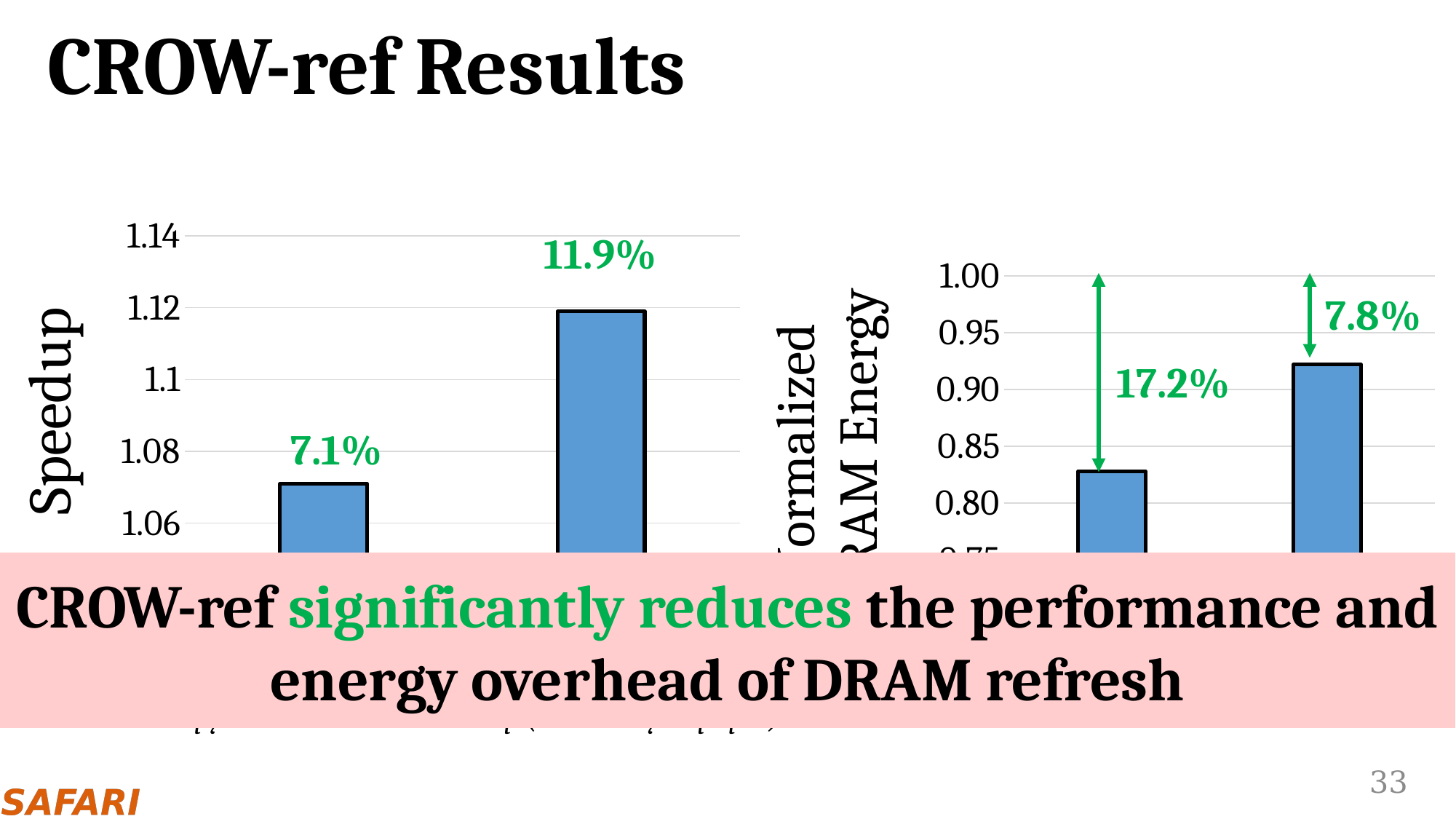
On the left chart (Speedup), is the value of the left bar greater or less than 1.08? less On the left chart (Speedup), what percentage label is printed above the right bar? 11.9% What is the y-axis title of the left chart? Speedup On the right chart (Normalized DRAM Energy), what percentage label is printed next to the right bar? 7.8% On the right chart (Normalized DRAM Energy), is the value of the left bar greater or less than 0.85? less On the right chart (Normalized DRAM Energy), what percentage label is printed next to the left bar? 17.2% On the left chart (Speedup), which bar is taller, the left bar or the right bar? the right bar On the right chart (Normalized DRAM Energy), is the value of the right bar greater or less than 0.90? greater On the left chart (Speedup), what percentage label is printed above the left bar? 7.1% What kind of chart is the right chart (Normalized DRAM Energy)? bar chart How many bars are plotted on the left chart (Speedup)? 2